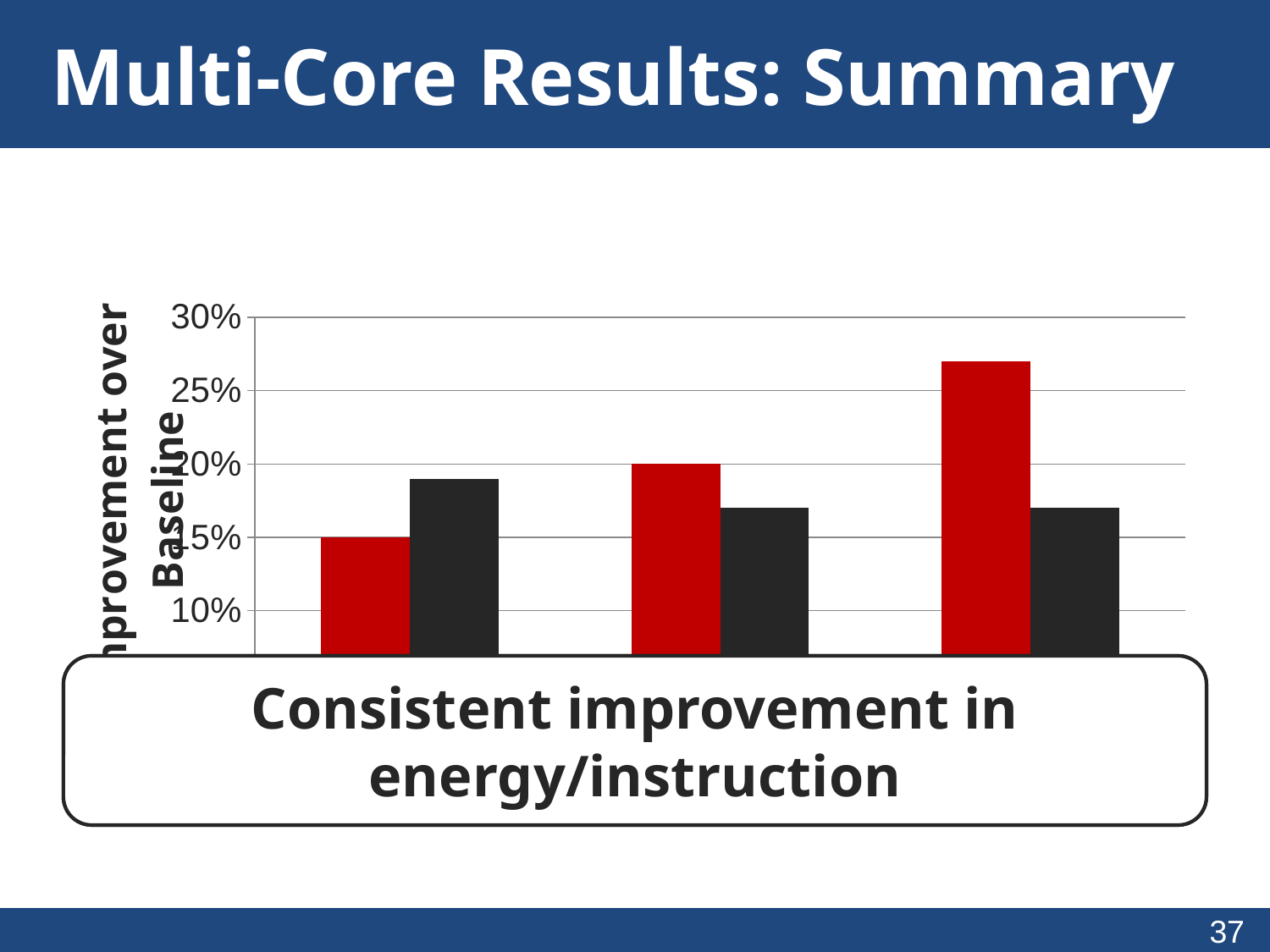
Is the value of the red bar in the third (rightmost) group greater or less than 25%? greater How many bars are in each group of the chart? 2 Which bar is the shortest in the chart? the red bar in the first (leftmost) group In the third (rightmost) group, which bar is taller, the red or the black one? red In the first (leftmost) group, which bar is taller, the red or the black one? black Which bar is the tallest in the chart? the red bar in the third (rightmost) group How many groups of bars does the chart show? 3 Do the red bars rise or fall from left to right across the groups? rise What kind of chart is shown on the slide? bar chart Is the value of the black bar in the second (middle) group greater or less than 20%? less What is the value of the red bar in the first (leftmost) group? 15% What is the value of the red bar in the second (middle) group? 20%